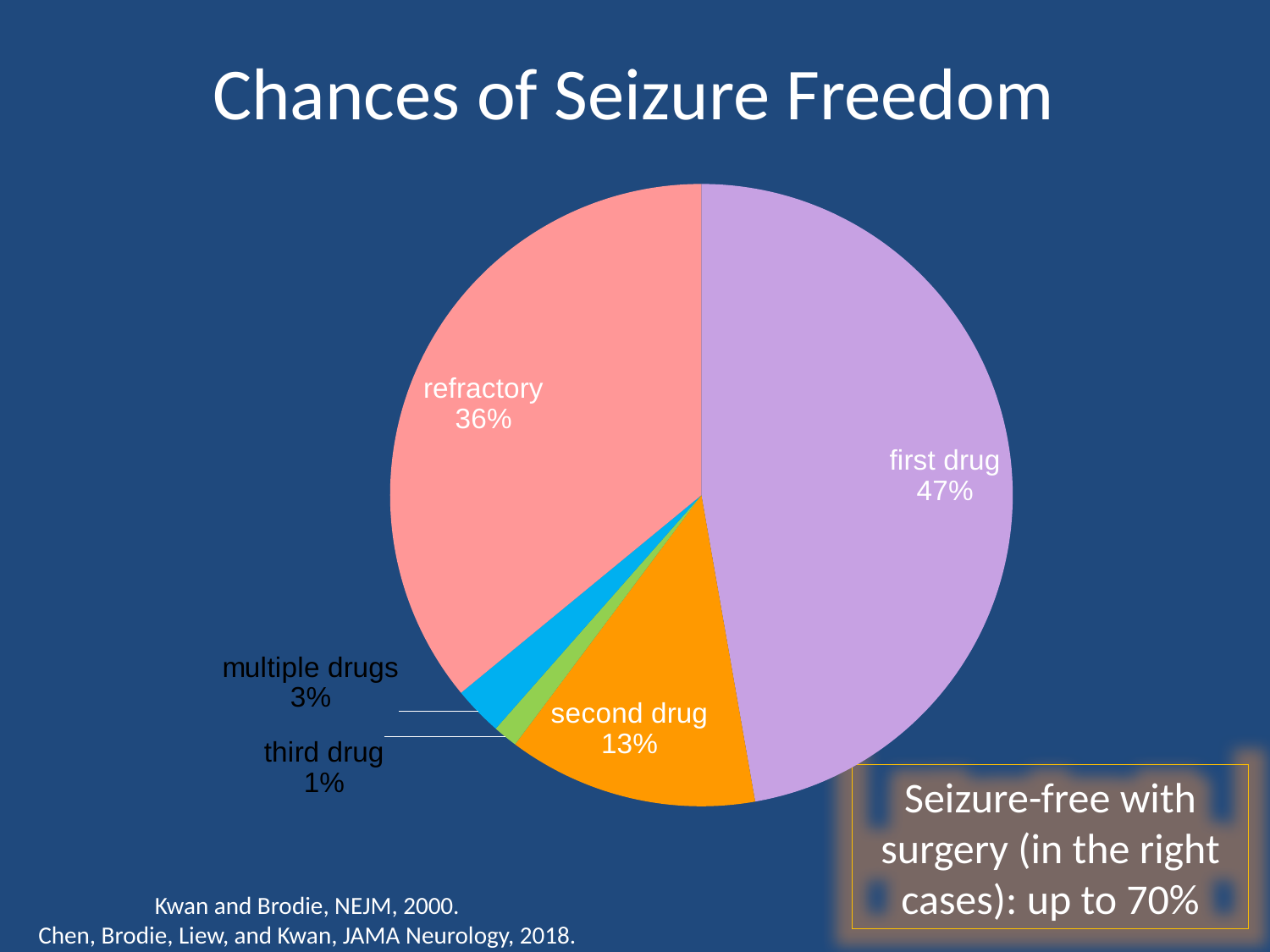
What is the title of the slide containing the pie chart? Chances of Seizure Freedom What percentage of the pie is labelled "second drug"? 13% What is the difference in percentage points between the "first drug" slice and the "refractory" slice? 11 What percentage of the pie is labelled "first drug"? 47% What kind of chart is shown on the slide? pie chart How many slices does the pie chart have? 5 What percentage of the pie is labelled "third drug"? 1% What percentage of the pie is labelled "refractory"? 36% Which slice is larger, "second drug" or "multiple drugs"? second drug Which slice of the pie is the largest? first drug What percentage of the pie is labelled "multiple drugs"? 3% Which slice of the pie is the smallest? third drug